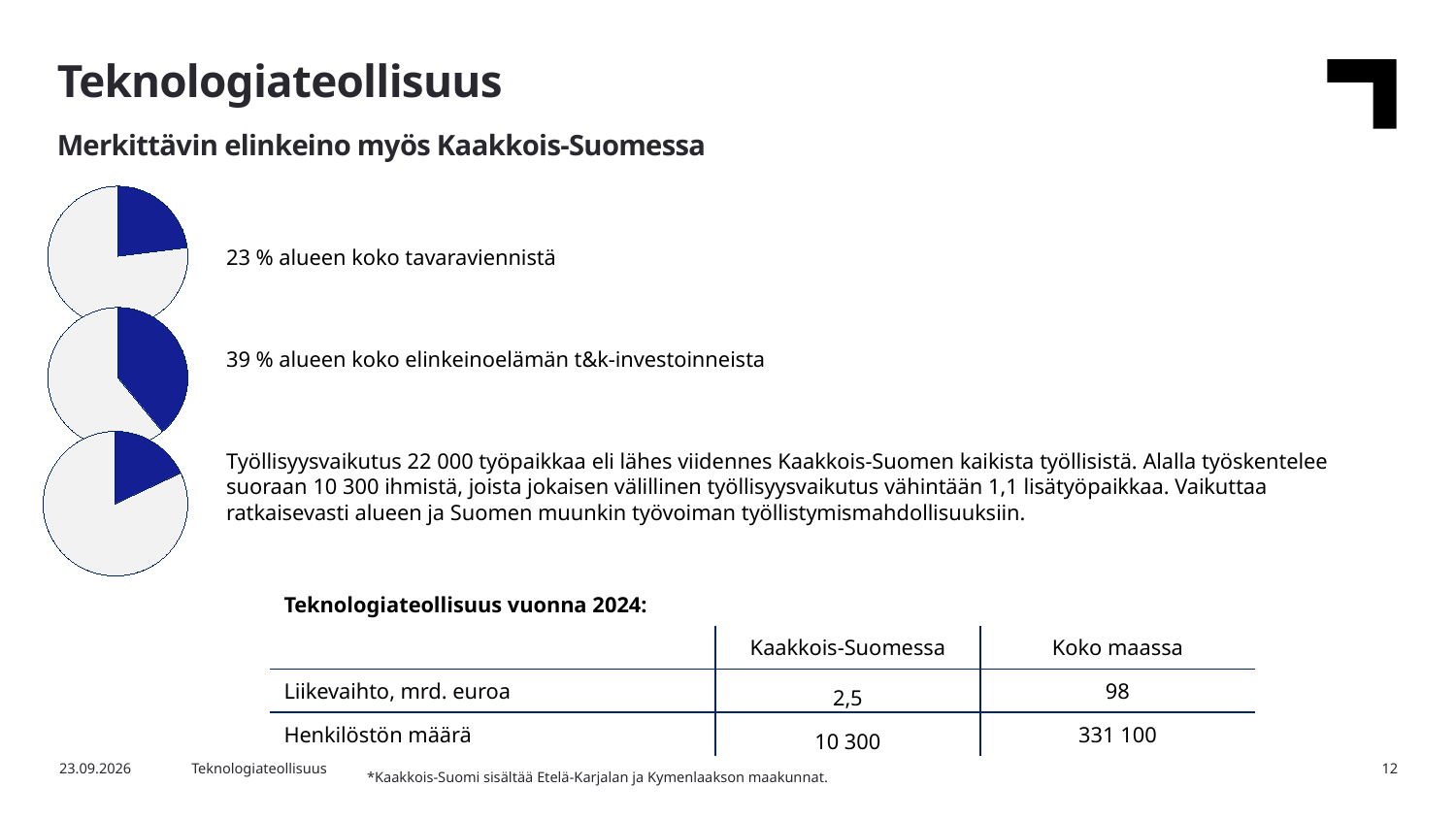
Is the blue slice larger in the top pie chart (goods exports) or the middle pie chart (R&D investments)? Middle pie chart (R&D investments) In the bottom pie chart, is the blue slice greater or less than 50% of the pie? less What colour is used for the highlighted slice in each pie chart? Blue In the middle pie chart, what share of the region's business R&D investments does the blue slice represent? 39 % What kind of charts are shown on the left side of the slide? Pie charts Which pie chart has the largest blue slice: the top, middle or bottom one? Middle In the middle pie chart, is the blue slice greater or less than 50% of the pie? less In the top pie chart, what share of the region's total goods exports does the blue slice represent? 23 % How many pie charts are on the slide? 3 What is the difference in percentage points between the shares shown by the middle pie chart (39 %) and the top pie chart (23 %)? 16 percentage points What is the main title of the slide containing the pie charts? Teknologiateollisuus